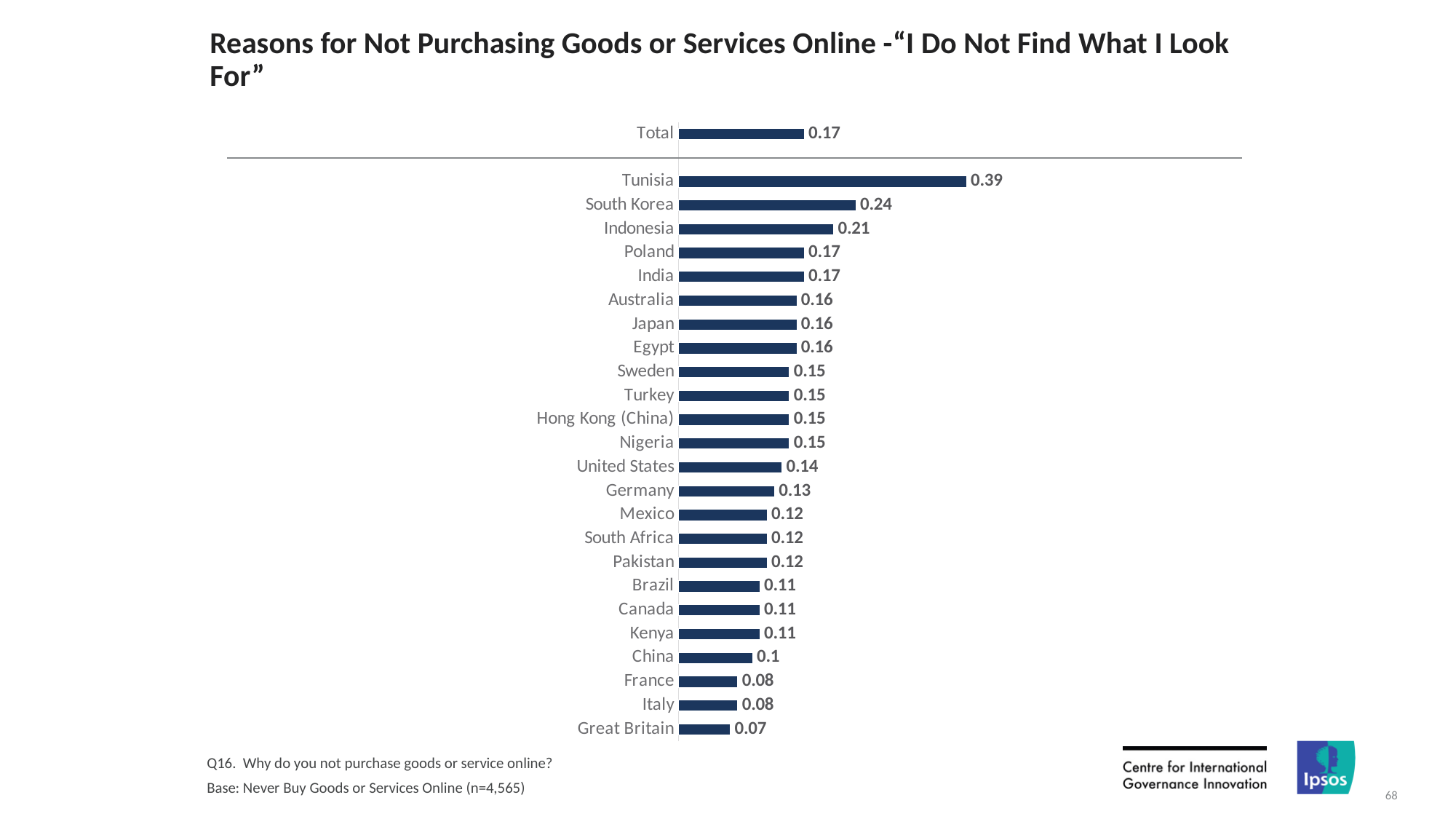
What is the value for the Total bar? 0.17 What is the difference between the values for Tunisia and South Korea? 0.15 What is the value for Tunisia? 0.39 Which is larger, the value for South Korea or the value for Indonesia? South Korea What is the value for China? 0.1 Which is larger, the value for Germany or the value for France? Germany What kind of chart is shown on the slide? Bar chart How many country bars are shown, excluding the Total bar? 24 What is the difference between the values for Indonesia and Great Britain? 0.14 Which country has the lowest value? Great Britain Which country has the highest value? Tunisia What is the value for Hong Kong (China)? 0.15